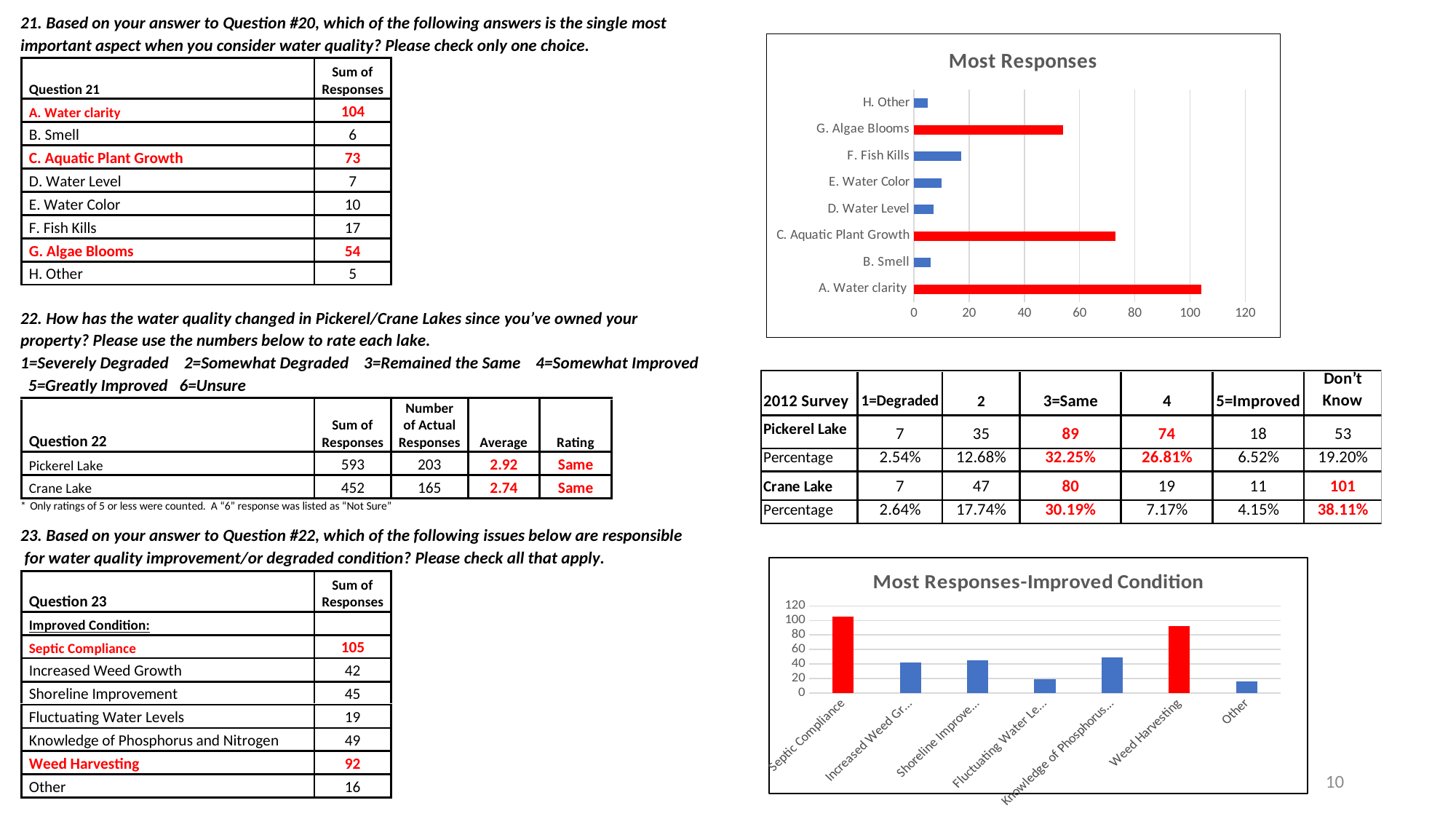
What kind of chart is the "Most Responses-Improved Condition" chart? bar chart How many categories are shown in the "Most Responses" chart? 8 In the "Most Responses" chart, is the value for G. Algae Blooms greater or less than 40? greater In the "Most Responses" chart, which category has the highest value? A. Water clarity In the "Most Responses-Improved Condition" chart, is the value for Weed Harvesting greater or less than 80? greater How many categories are shown in the "Most Responses-Improved Condition" chart? 7 What kind of chart is the "Most Responses" chart? bar chart In the "Most Responses" chart, what is the value for A. Water clarity? 104 In the "Most Responses-Improved Condition" chart, which bars are coloured red? Septic Compliance and Weed Harvesting In the "Most Responses" chart, which is larger: C. Aquatic Plant Growth or G. Algae Blooms? C. Aquatic Plant Growth In the "Most Responses" chart, is the value for F. Fish Kills greater or less than 20? less In the "Most Responses-Improved Condition" chart, which category has the highest value? Septic Compliance